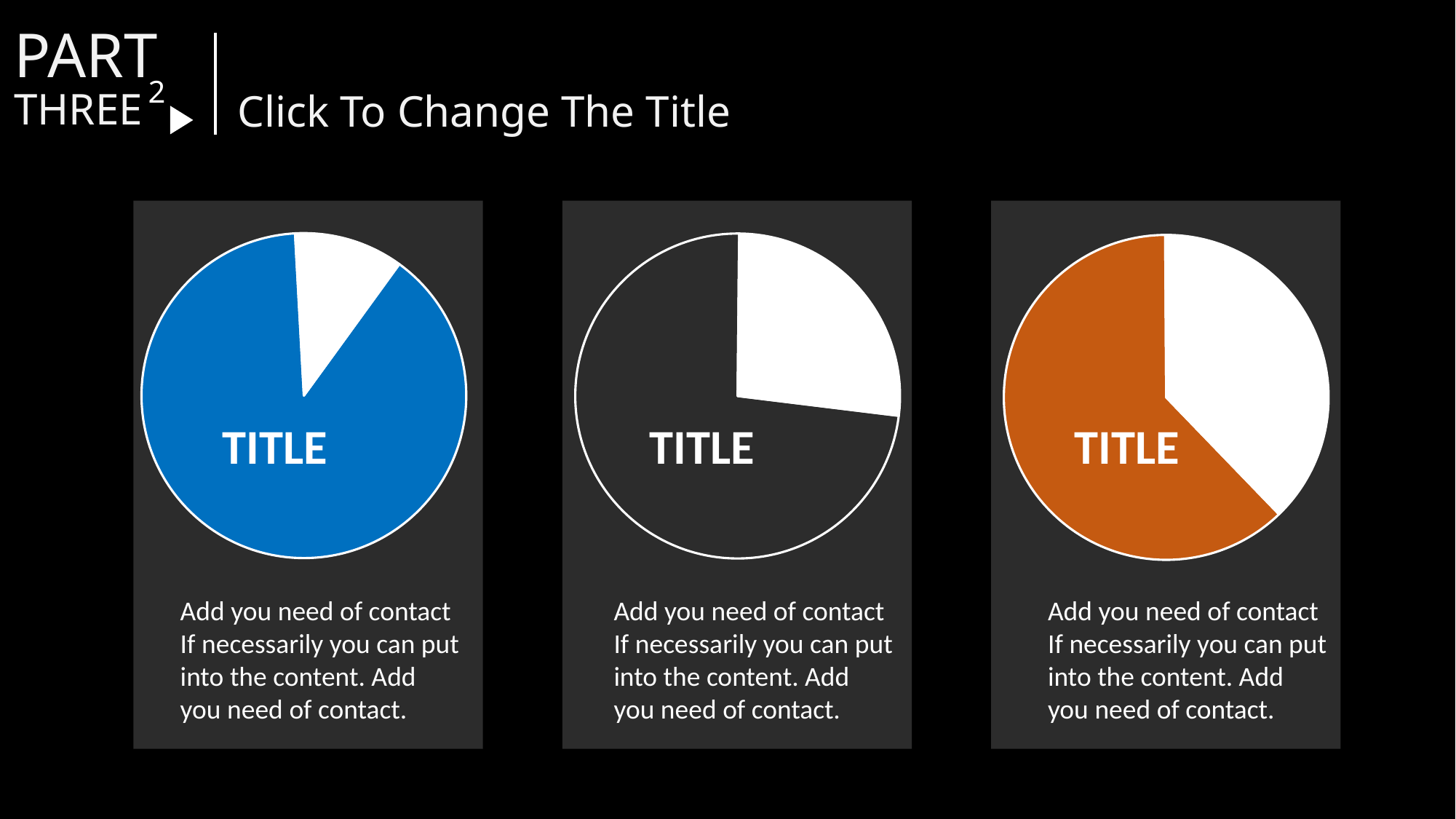
What colour is the larger slice of the pie chart in the right panel? orange How many slices does the pie chart in the left panel have? 2 In the left panel's pie chart, which slice is larger, the blue slice or the white slice? the blue slice What kind of chart is shown in the left panel of the slide? pie chart In the right panel's pie chart, which slice is larger, the orange slice or the white slice? the orange slice How many pie charts are shown on the slide? 3 What kind of chart is shown in the right panel of the slide? pie chart How many slices does the pie chart in the right panel have? 2 In the middle panel's pie chart, which slice is larger, the dark slice or the white slice? the dark slice What text label is printed on each of the three pie charts? TITLE What kind of chart is shown in the middle panel of the slide? pie chart